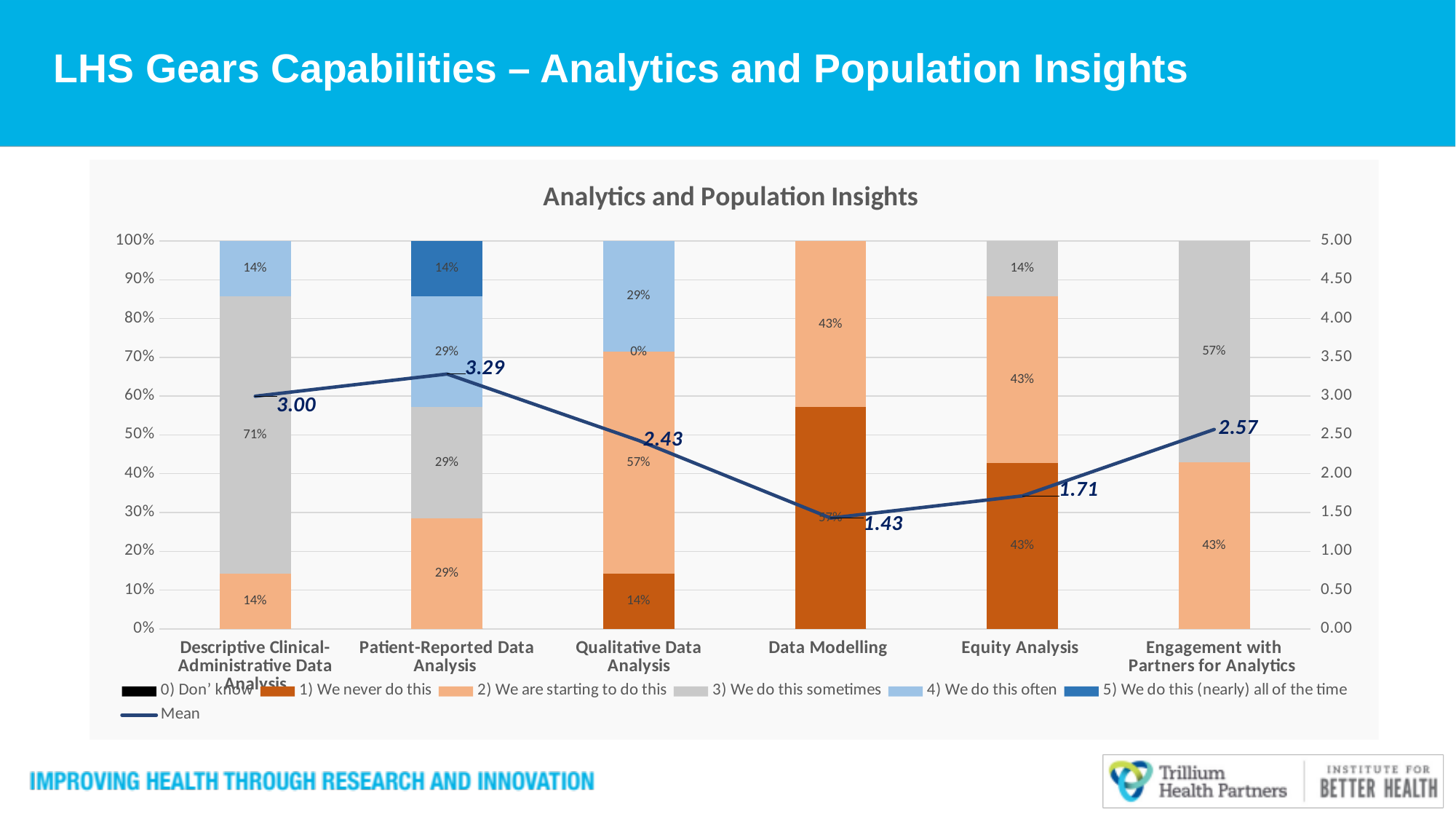
What kind of chart is this? Stacked bar chart with a line for the Mean What is the title of the chart? Analytics and Population Insights What percentage of respondents chose '3) We do this sometimes' for Descriptive Clinical-Administrative Data Analysis? 71% What is the Mean value for Data Modelling? 1.43 How many series does the legend list? 7 What is the difference between the Mean for Patient-Reported Data Analysis and the Mean for Data Modelling? 1.86 Which category has the highest Mean value? Patient-Reported Data Analysis Which category has the lowest Mean value? Data Modelling What percentage chose '5) We do this (nearly) all of the time' for Patient-Reported Data Analysis? 14% How many categories are shown on the x axis? 6 What percentage chose '2) We are starting to do this' for Engagement with Partners for Analytics? 43% Which has the larger Mean value, Equity Analysis or Engagement with Partners for Analytics? Engagement with Partners for Analytics